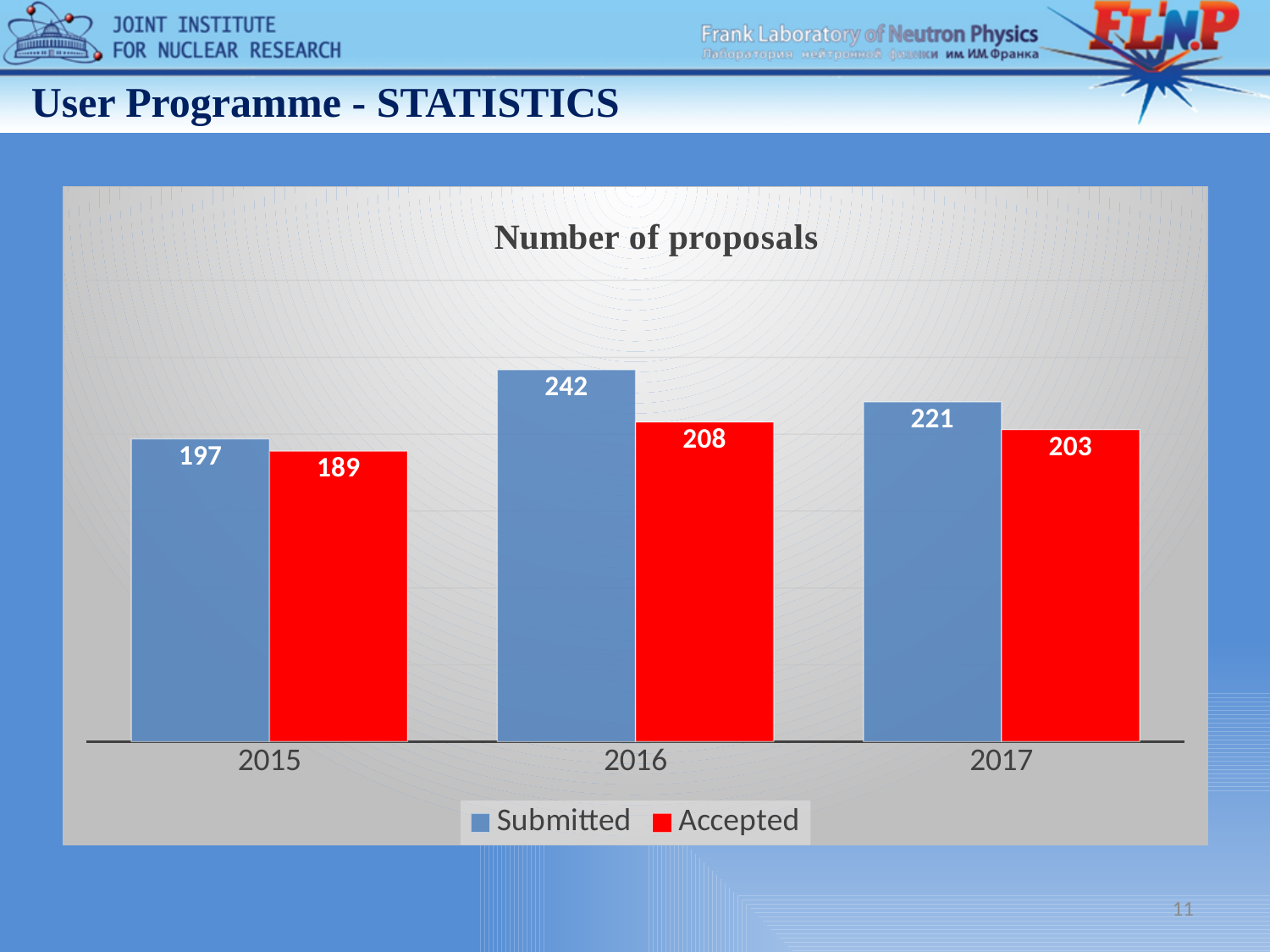
Which is larger: the number of accepted proposals in 2016 or in 2017? 2016 What kind of chart is shown on the slide? Bar chart What is the number of accepted proposals in 2017? 203 What is the title of the chart? Number of proposals In which year was the number of submitted proposals highest? 2016 What is the number of submitted proposals in 2016? 242 How many more proposals were submitted in 2016 than in 2017? 21 What is the number of accepted proposals in 2015? 189 In which year was the number of accepted proposals lowest? 2015 How many series does the legend list? 2 What is the difference between submitted and accepted proposals in 2016? 34 How many years are shown on the x axis? 3